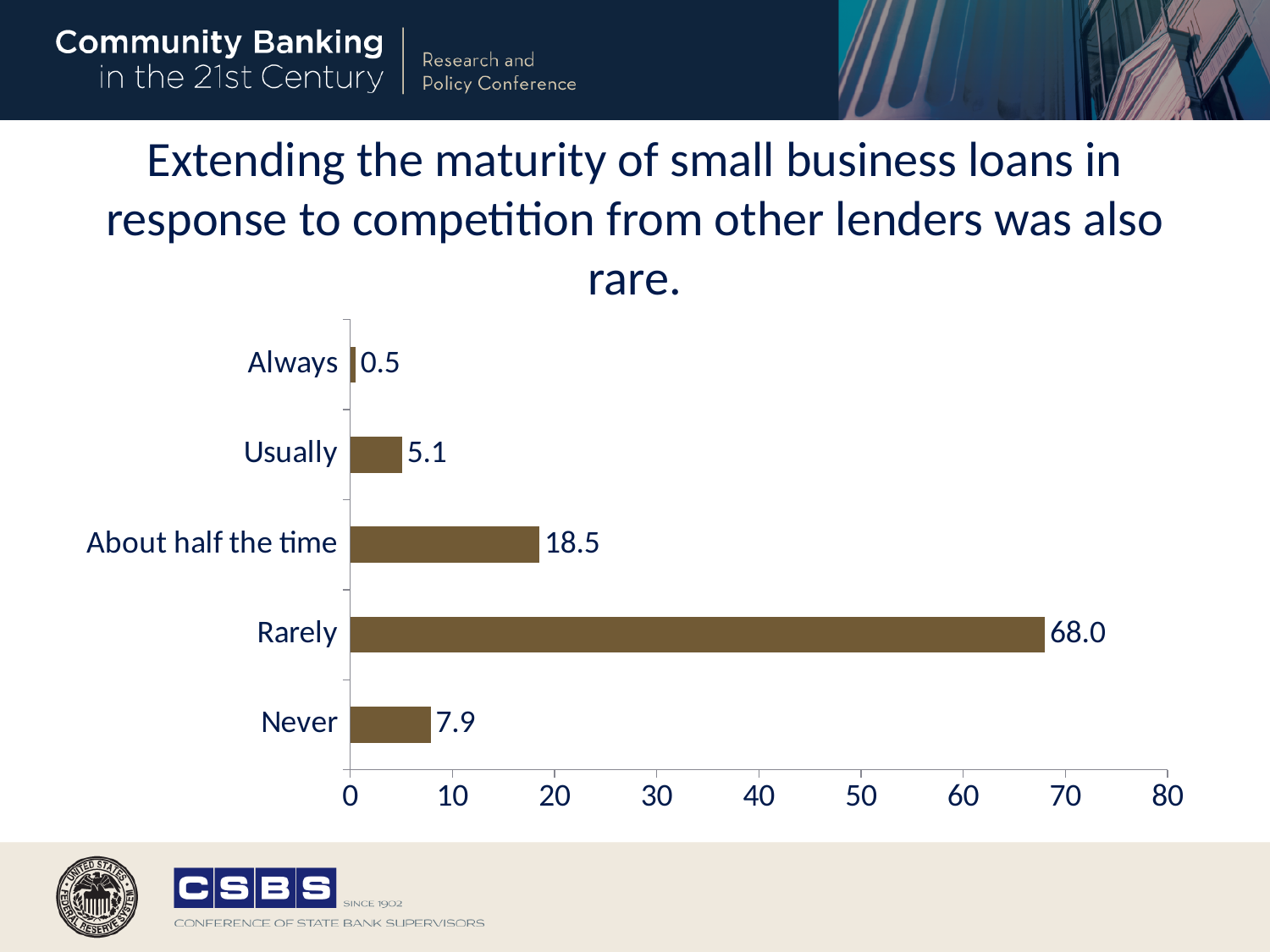
What is the value for Rarely? 68.0 What kind of chart is shown on the slide? Bar chart Is the value for Rarely greater or less than 60? greater What is the value for Never? 7.9 Which category has the lowest value? Always What is the difference between the values for Never and Usually? 2.8 Which is larger, the value for Never or the value for Usually? Never How many categories are shown in the chart? 5 What is the value for Always? 0.5 What is the value for About half the time? 18.5 What is the difference between the values for Rarely and About half the time? 49.5 Which category has the highest value? Rarely